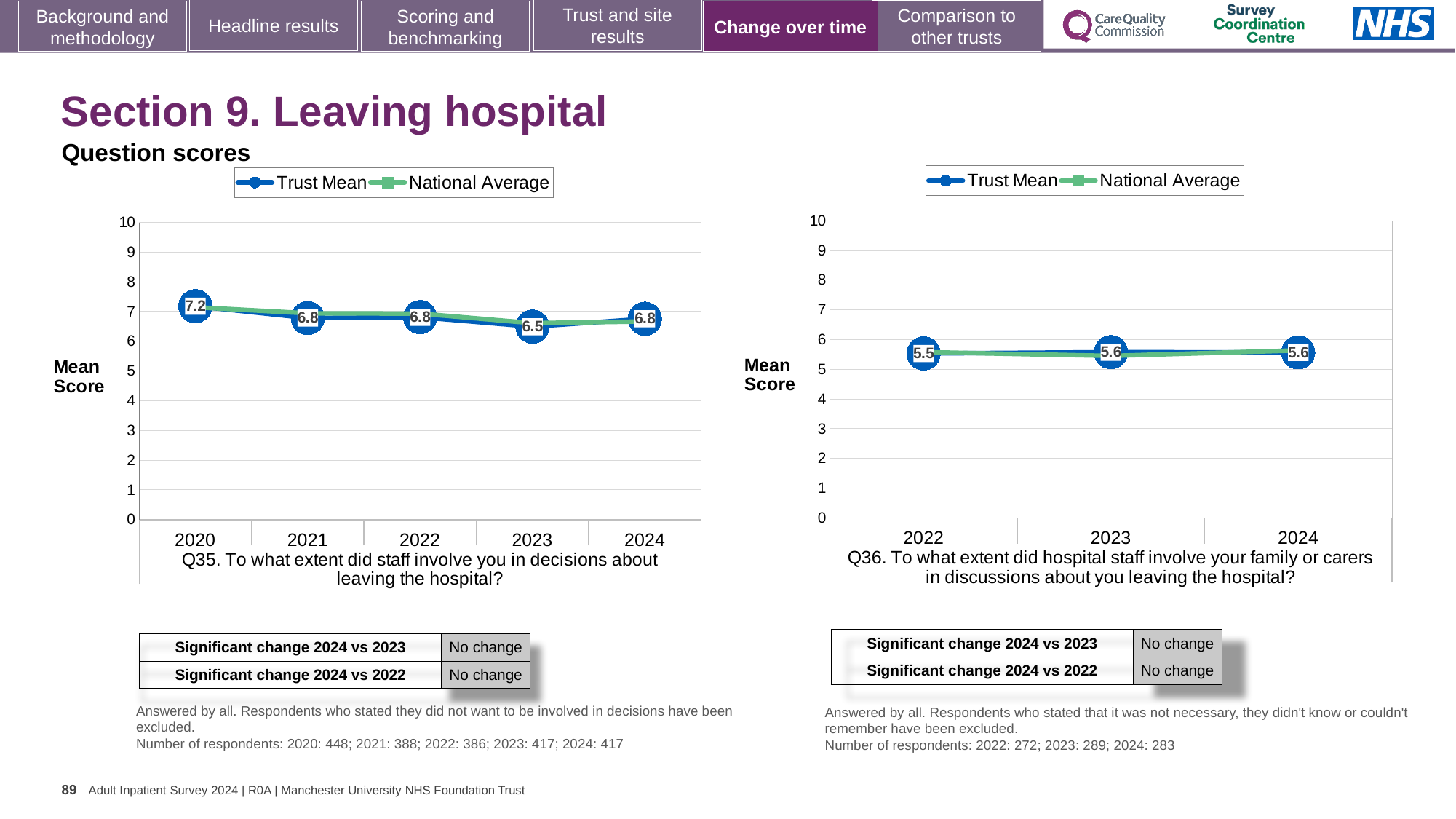
How many series does the legend of the Q35 chart on the left list? 2 In the Q36 chart on the right, what is the Trust Mean score for 2022? 5.5 In the Q35 chart on the left, what is the Trust Mean score for 2023? 6.5 In the Q36 chart on the right, what is the difference between the Trust Mean scores for 2024 and 2022? 0.1 In the Q35 chart on the left, which year has the lowest Trust Mean score? 2023 How many years are plotted in the Q36 chart on the right? 3 In the Q35 chart on the left, which year has the highest Trust Mean score? 2020 What kind of chart is the Q35 chart on the left? Line chart In the Q35 chart on the left, what is the difference between the Trust Mean scores for 2020 and 2023? 0.7 In the Q36 chart on the right, is the Trust Mean score for 2023 greater or less than 6? less Which is larger: the Trust Mean score for 2024 in the Q35 chart or the Trust Mean score for 2024 in the Q36 chart? Q35 chart (6.8) In the Q35 chart on the left, what is the Trust Mean score for 2020? 7.2